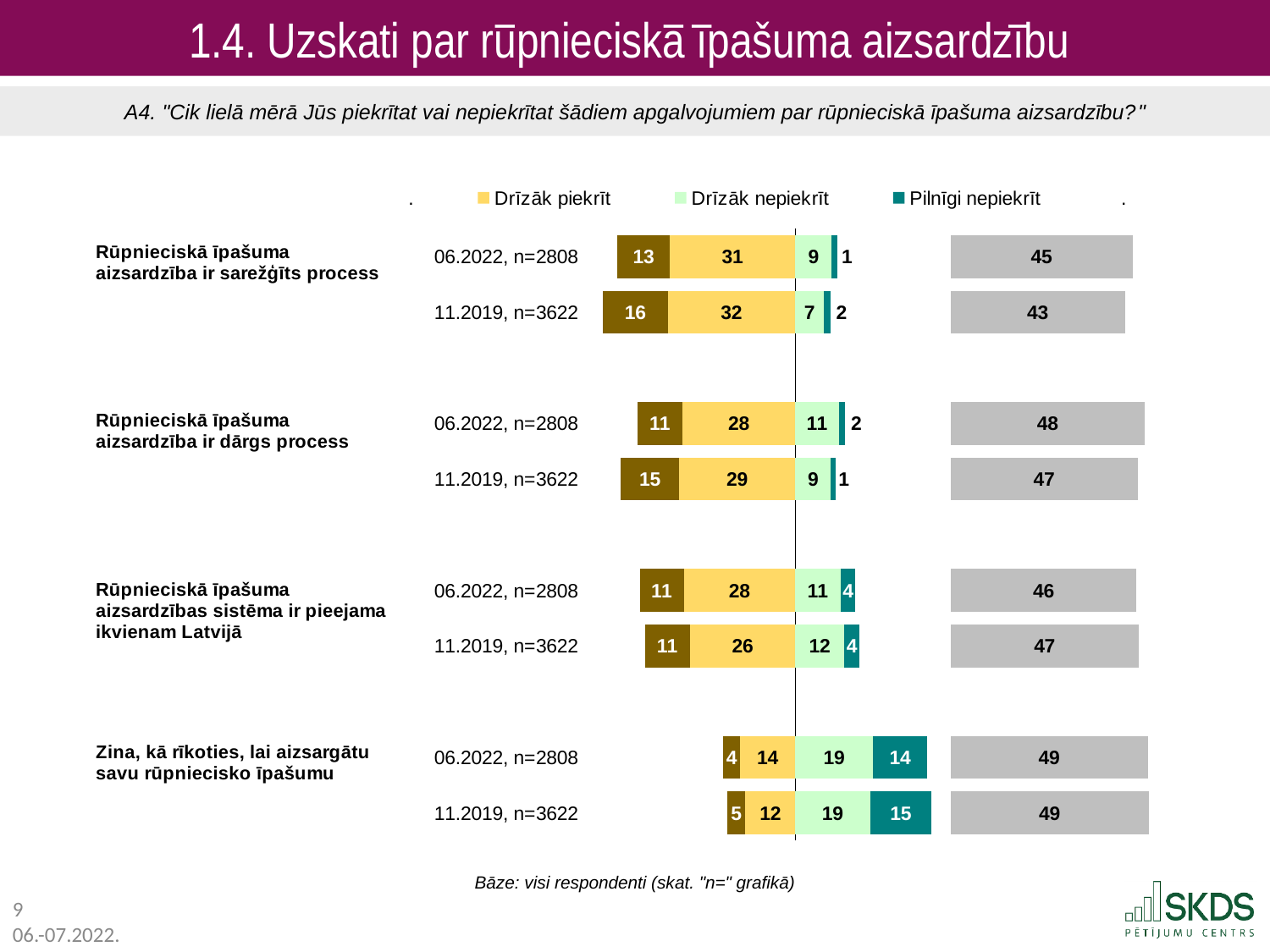
What is the "Drīzāk nepiekrīt" value for "Zina, kā rīkoties, lai aizsargātu savu rūpniecisko īpašumu" in 11.2019, n=3622? 19 Which statement has the highest "Drīzāk piekrīt" value in 06.2022, n=2808? Rūpnieciskā īpašuma aizsardzība ir sarežģīts process For "Rūpnieciskā īpašuma aizsardzība ir dārgs process", what is the difference between the "Drīzāk nepiekrīt" values for 06.2022 and 11.2019? 2 For "Rūpnieciskā īpašuma aizsardzība ir dārgs process", what is the difference between the "Drīzāk piekrīt" values for 11.2019 and 06.2022? 1 For "Zina, kā rīkoties, lai aizsargātu savu rūpniecisko īpašumu", which survey wave has the larger "Pilnīgi nepiekrīt" value, 06.2022 or 11.2019? 11.2019 What kind of chart is shown on the slide? Bar chart What is the sample size (n) shown for the 06.2022 survey wave? 2808 What is the "Drīzāk nepiekrīt" value for "Rūpnieciskā īpašuma aizsardzības sistēma ir pieejama ikvienam Latvijā" in 11.2019, n=3622? 12 What is the "Drīzāk piekrīt" value for "Rūpnieciskā īpašuma aizsardzība ir sarežģīts process" in 06.2022, n=2808? 31 Which statement has the lowest "Drīzāk piekrīt" value in 11.2019, n=3622? Zina, kā rīkoties, lai aizsargātu savu rūpniecisko īpašumu How many statements are shown in the chart? 4 What is the "Pilnīgi nepiekrīt" value for "Zina, kā rīkoties, lai aizsargātu savu rūpniecisko īpašumu" in 06.2022, n=2808? 14